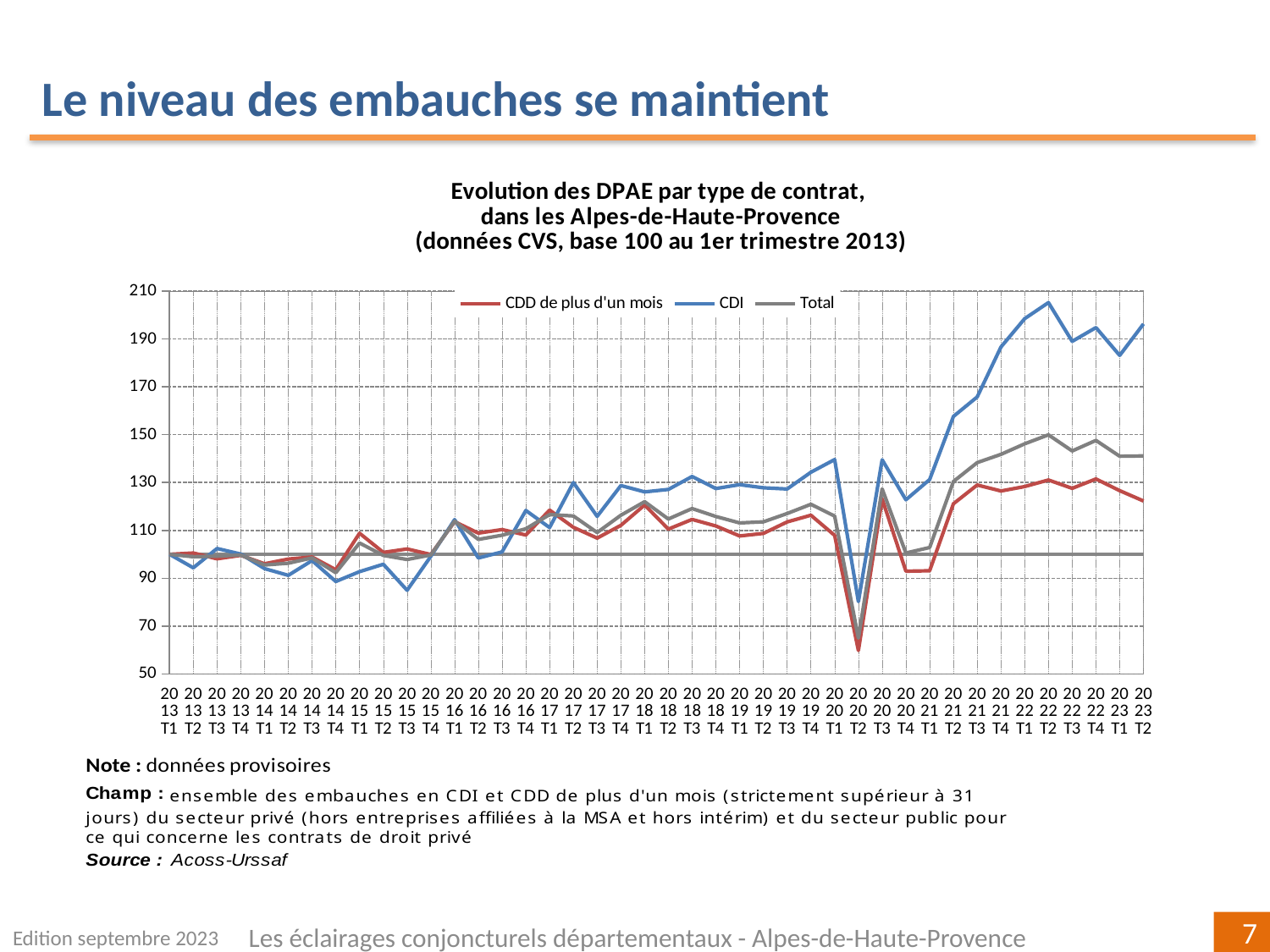
Which series are listed in the legend? CDD de plus d'un mois, CDI, Total How many series does the legend list? 3 Is the value of the Total series at 2023 T2 greater or less than 130? greater Which quarter is the base 100 reference period according to the chart title? 1er trimestre 2013 In which quarter does the CDI series reach its lowest value? 2020 T2 What kind of chart is shown on the slide? line chart Is the value of the CDD de plus d'un mois series at 2020 T2 greater or less than 70? less How many quarters are plotted along the x axis? 42 Is the value of the CDI series at 2023 T2 greater or less than 190? greater Which series has the highest value at 2023 T2? CDI Does the CDI series rise or fall between 2020 T2 and 2022 T2? rise In which quarter does the CDI series reach its highest value? 2022 T2